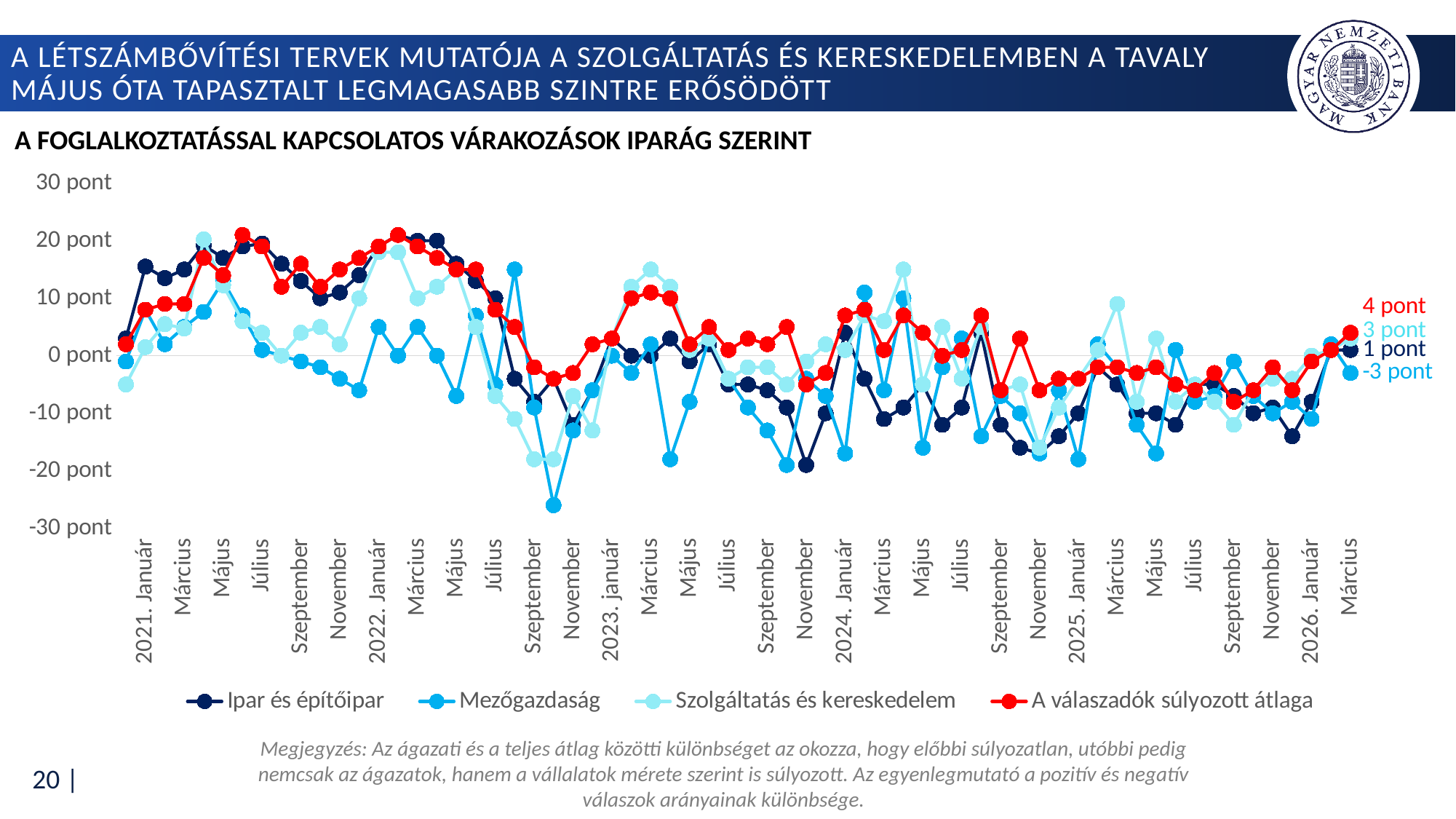
What is the latest (2026 March) value for A válaszadók súlyozott átlaga? 4 pont Which series has the highest value at the end of the chart (2026 March)? A válaszadók súlyozott átlaga Is the lowest value reached by the Mezőgazdaság series greater or less than -20 pont? less What is the latest (2026 March) value for Ipar és építőipar? 1 pont How many series does the legend list? 4 At the end of the chart, which is larger: the value for Szolgáltatás és kereskedelem or for Ipar és építőipar? Szolgáltatás és kereskedelem What is the difference between the latest values of A válaszadók súlyozott átlaga and Mezőgazdaság? 7 pont What is the latest (2026 March) value for Mezőgazdaság? -3 pont What is the title of the chart? A FOGLALKOZTATÁSSAL KAPCSOLATOS VÁRAKOZÁSOK IPARÁG SZERINT Which series has the lowest value at the end of the chart (2026 March)? Mezőgazdaság What is the latest (2026 March) value for Szolgáltatás és kereskedelem? 3 pont What kind of chart is shown on the slide? line chart